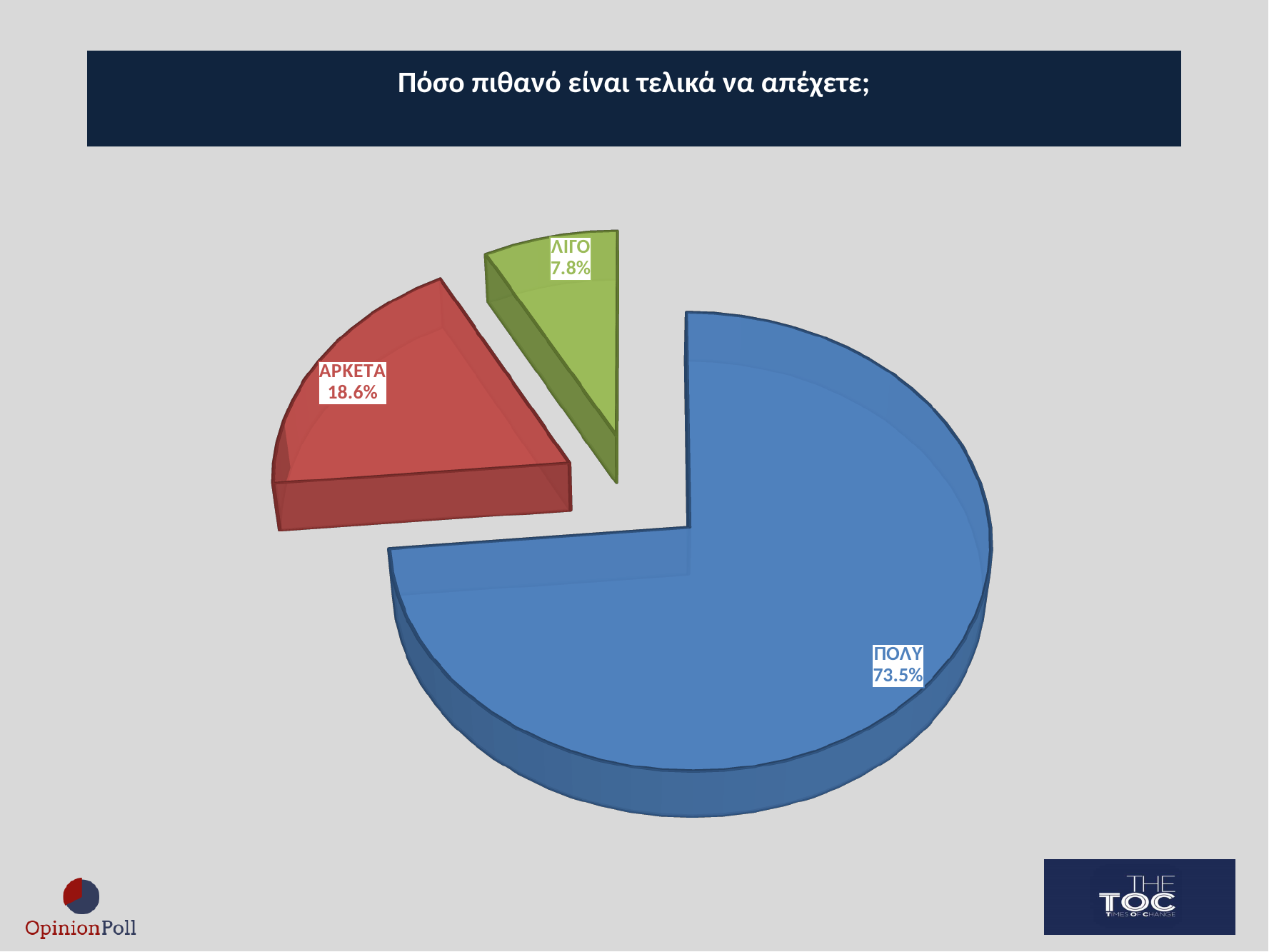
How many slices does the pie chart have? 3 What is the value for ΠΟΛΥ? 73.5% What colour is the ΠΟΛΥ slice? Blue What is the value for ΛΙΓΟ? 7.8% Which category has the largest share of the pie? ΠΟΛΥ What is the difference between the values for ΠΟΛΥ and ΑΡΚΕΤΑ? 54.9% What type of chart is shown on the slide? Pie chart Which is larger, the value for ΑΡΚΕΤΑ or the value for ΛΙΓΟ? ΑΡΚΕΤΑ What is the value for ΑΡΚΕΤΑ? 18.6% What is the difference between the values for ΑΡΚΕΤΑ and ΛΙΓΟ? 10.8% What is the title of the chart? Πόσο πιθανό είναι τελικά να απέχετε; Which category has the smallest share of the pie? ΛΙΓΟ